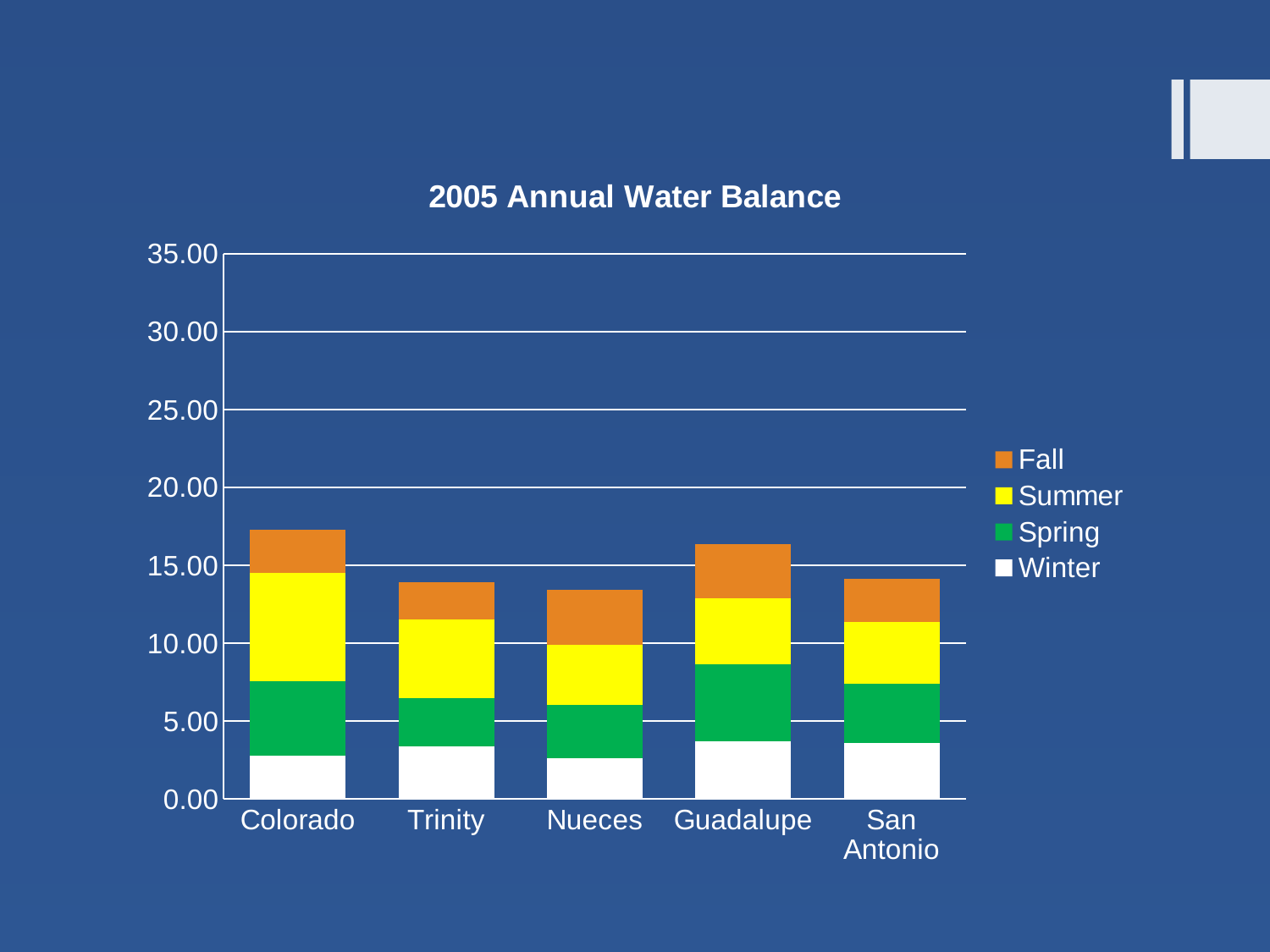
Which has the larger total stacked bar, Colorado or Nueces? Colorado How many river basins (categories) are shown on the x axis? 5 Which colour represents the Summer series in the legend? Yellow Is the total stacked value for Nueces greater or less than 15.00? less How many series does the legend list? 4 What is the title of the chart? 2005 Annual Water Balance Which category has the highest total stacked bar? Colorado Is the total stacked value for Guadalupe greater or less than 15.00? greater What kind of chart is shown on the slide? Stacked bar chart Is the total stacked value for Colorado greater or less than 15.00? greater Which has the larger total stacked bar, Guadalupe or Trinity? Guadalupe